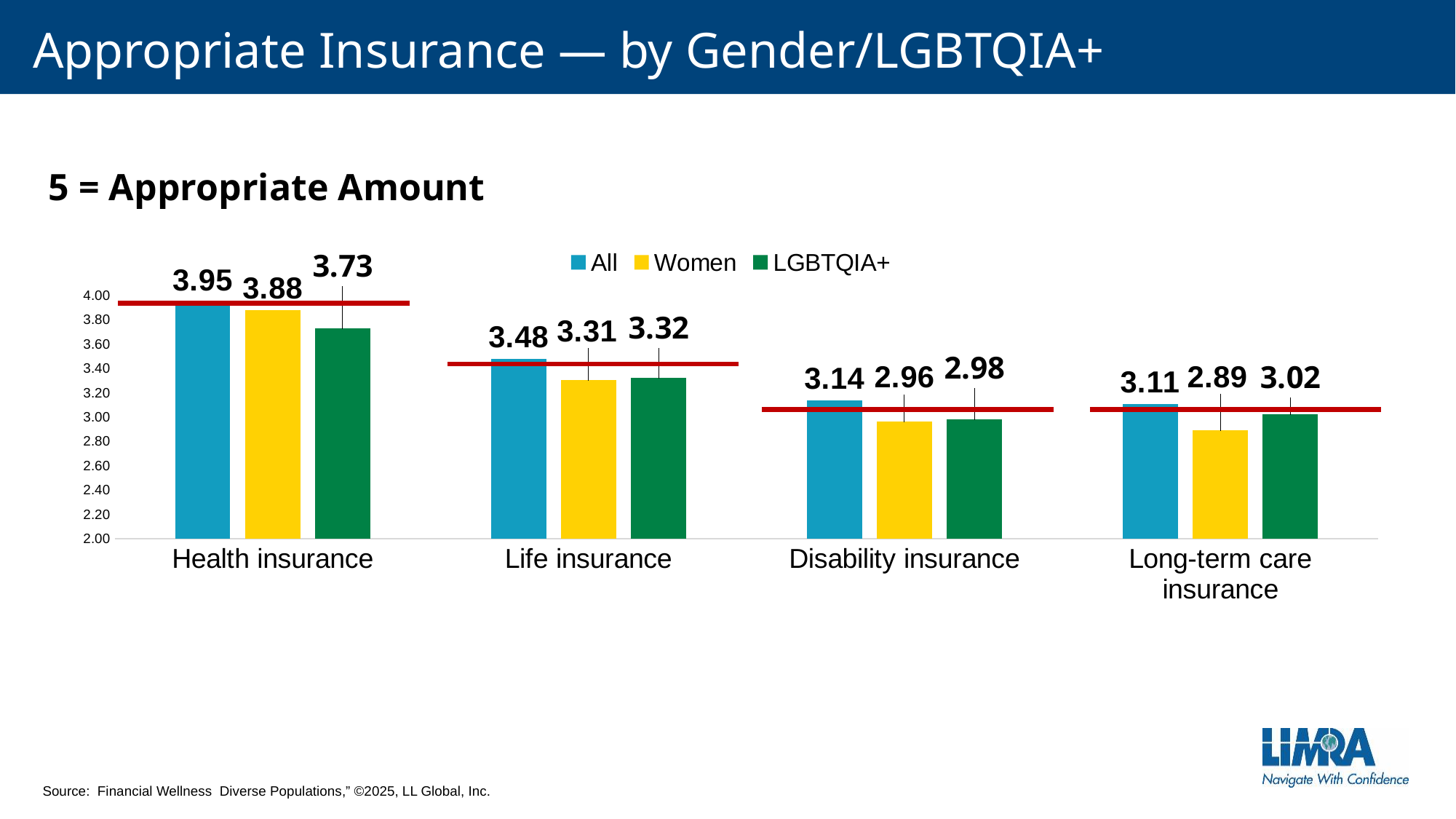
Which is larger for Long-term care insurance: the Women value or the LGBTQIA+ value? LGBTQIA+ Which insurance category has the highest value for the All series? Health insurance What is the value for Women for Health insurance? 3.88 What is the value for LGBTQIA+ for Disability insurance? 2.98 What is the value for All for Long-term care insurance? 3.11 What is the difference between the All value and the Women value for Life insurance? 0.17 Do the values for the All series rise or fall from Health insurance to Long-term care insurance? Fall Which series is shown in yellow? Women Which insurance category has the lowest value for the Women series? Long-term care insurance How many series does the legend list? 3 What kind of chart is shown on the slide? Bar chart How many insurance categories are shown on the x axis? 4